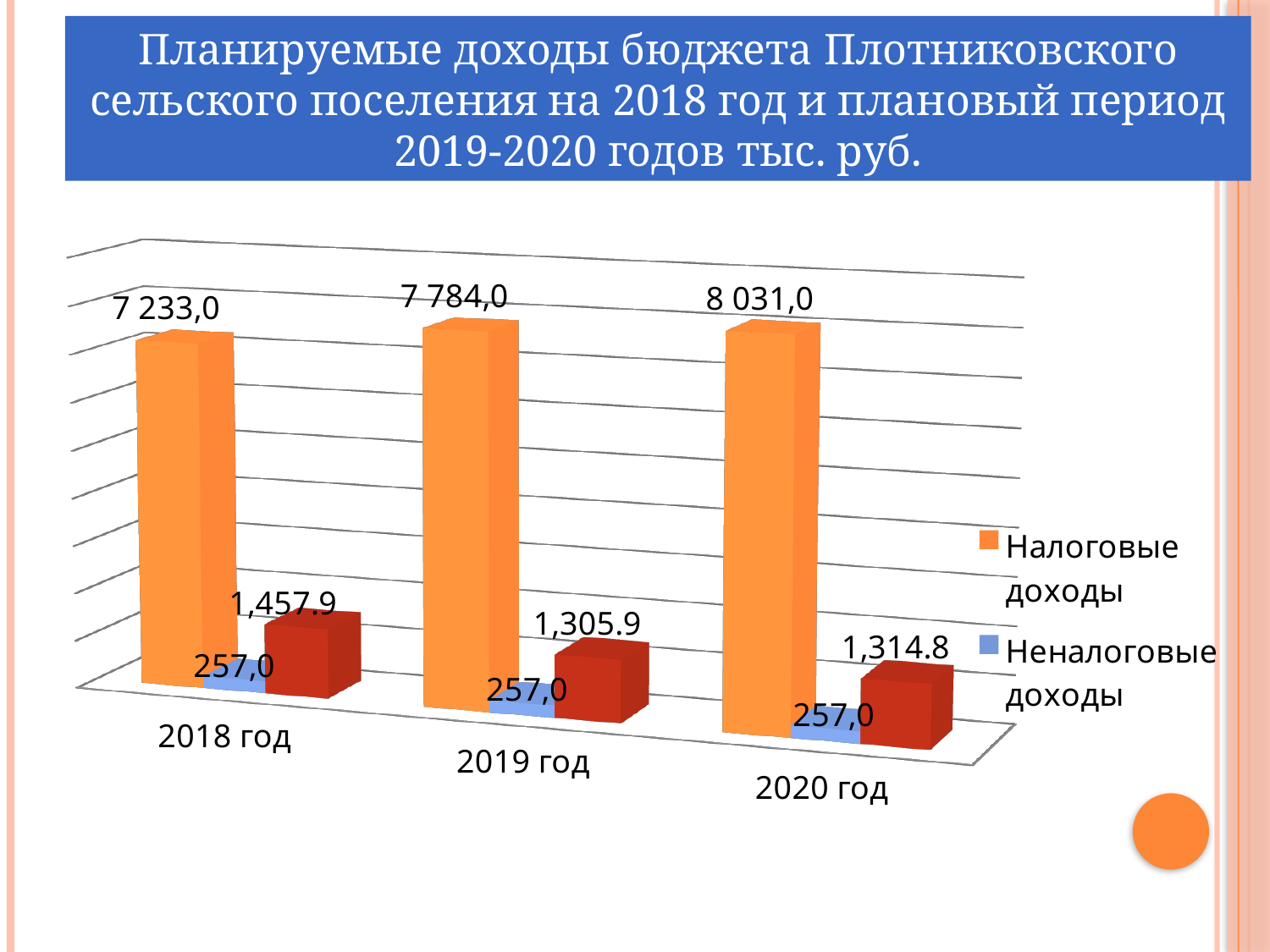
In which year are Налоговые доходы the highest? 2020 год What is the difference between Налоговые доходы in 2019 год and 2018 год? 551,0 Do Налоговые доходы rise or fall from 2018 год to 2020 год? Rise In which year are Налоговые доходы the lowest? 2018 год What is the value of Налоговые доходы for 2018 год? 7 233,0 Which year has larger Налоговые доходы, 2019 год or 2020 год? 2020 год By how much do Налоговые доходы in 2020 год exceed those in 2018 год? 798,0 What is the value of Налоговые доходы for 2020 год? 8 031,0 What kind of chart is shown on the slide? Bar chart What is the value of Неналоговые доходы for 2019 год? 257,0 How many years are shown on the x axis of the chart? 3 What colour represents Налоговые доходы in the legend? Orange